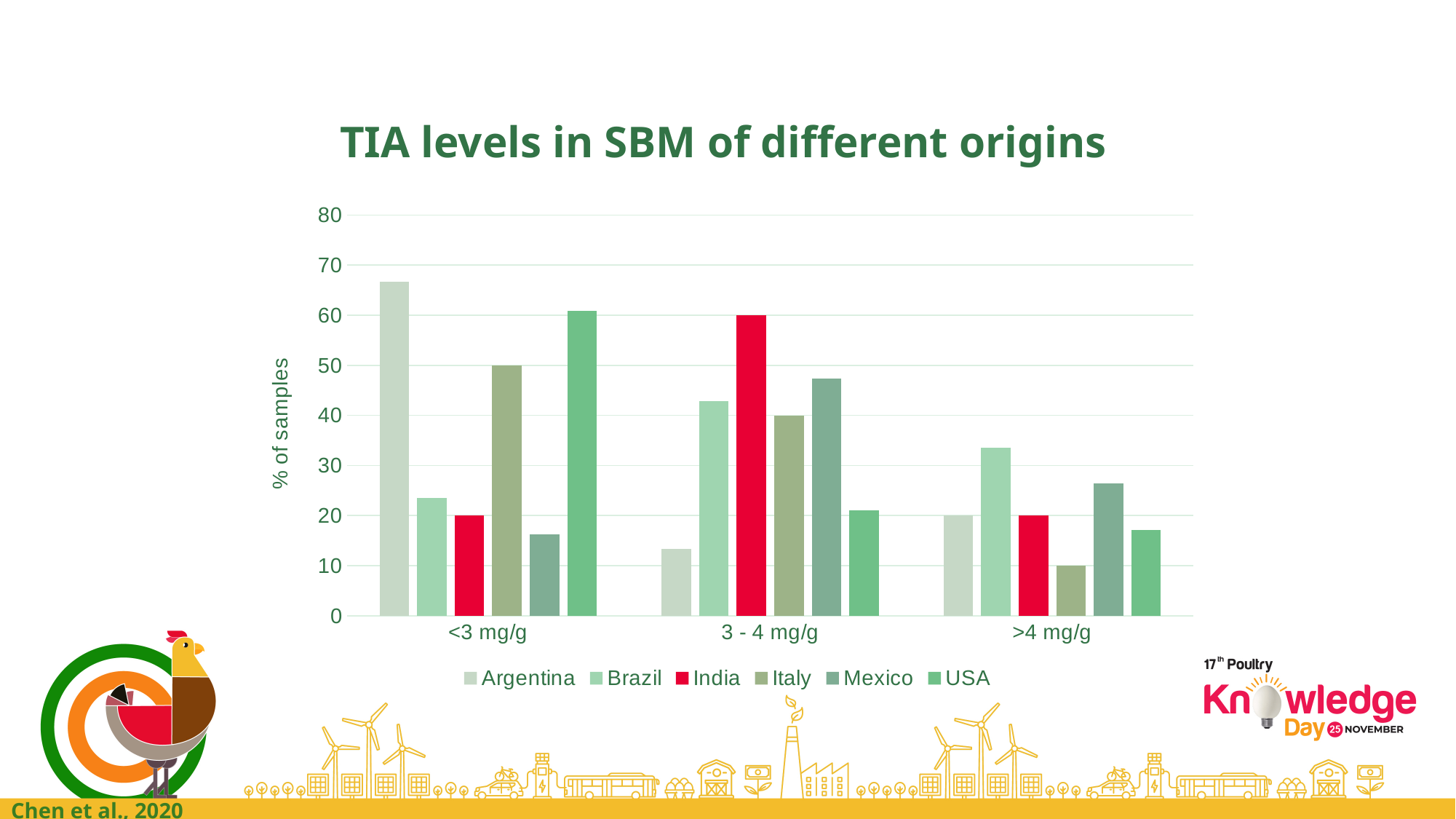
How many TIA level categories are shown on the x axis? 3 What is the difference between India's value in the 3 - 4 mg/g category and its value in the <3 mg/g category? 40 What type of chart is shown on the slide? bar chart Which origin has the highest value in the <3 mg/g category? Argentina What is the label of the y axis? % of samples Is the value for USA in the <3 mg/g category greater or less than 50? greater How many series does the legend list? 6 What is the value for India in the 3 - 4 mg/g category? 60 Which is larger in the >4 mg/g category, Brazil or Mexico? Brazil Which origin has the lowest value in the 3 - 4 mg/g category? Argentina What is the value for Italy in the >4 mg/g category? 10 What is the value for Italy in the <3 mg/g category? 50